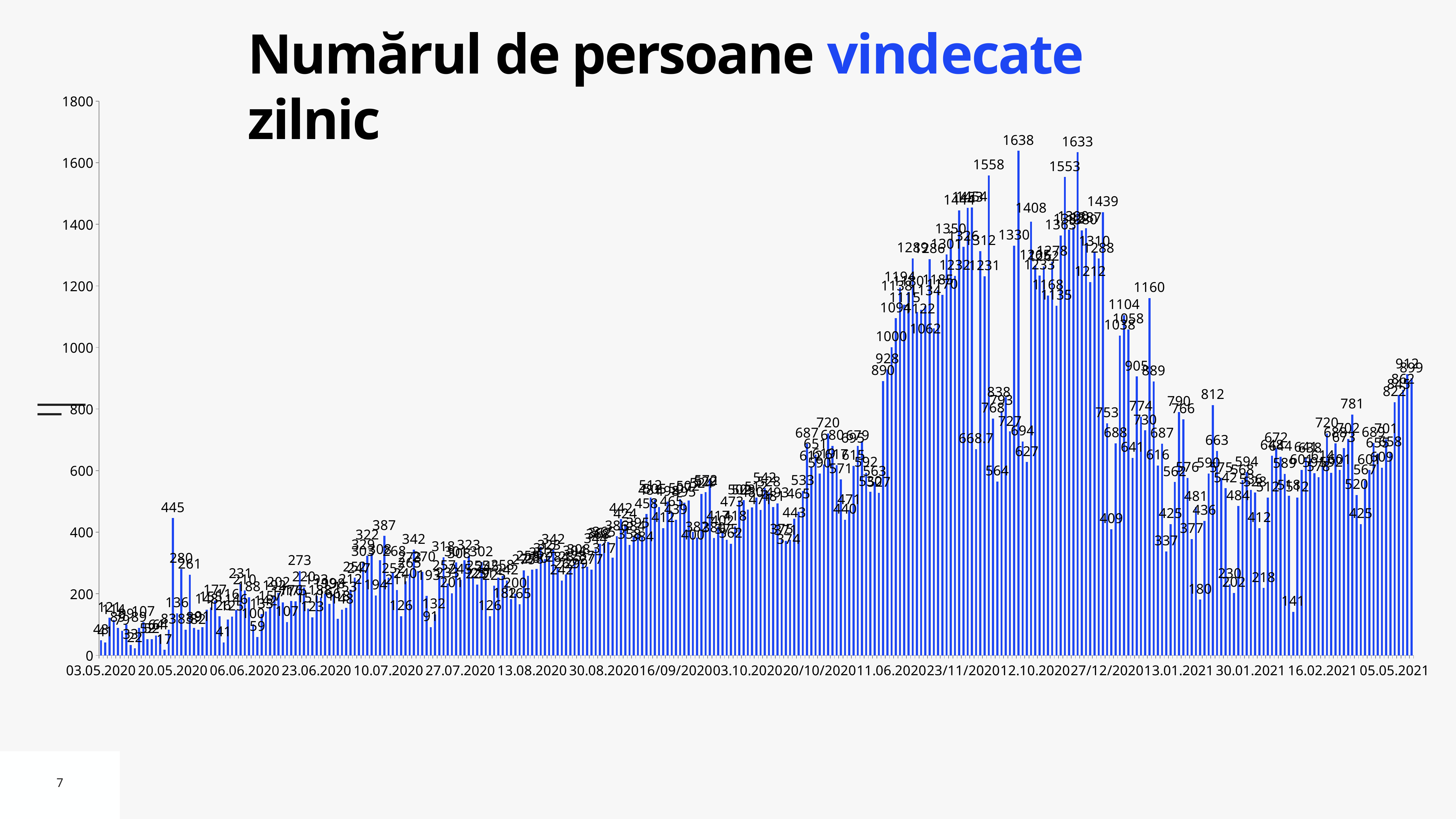
Do the values generally rise or fall from May 2020 to November 2020? rise What is the title of the chart? Numărul de persoane vindecate zilnic What is the maximum value shown on the vertical axis? 1800 Is the value of the first bar (03.05.2020) greater or less than 200? less What is the lowest labelled value on the chart? 17 What is the value of the tall isolated bar labelled near 20.05.2020 that stands out above its neighbours? 445 What is the difference between the two tallest bars, labelled 1638 and 1633? 5 What kind of chart is shown on the slide? bar chart Which is larger: the bar labelled 1558 or the bar labelled 1553? 1558 Is the value of the last bar (05.05.2021) greater or less than 800? greater What is the highest daily value shown on the chart? 1638 What is the second-highest labelled value on the chart, shown just to the right of the 1638 peak? 1633